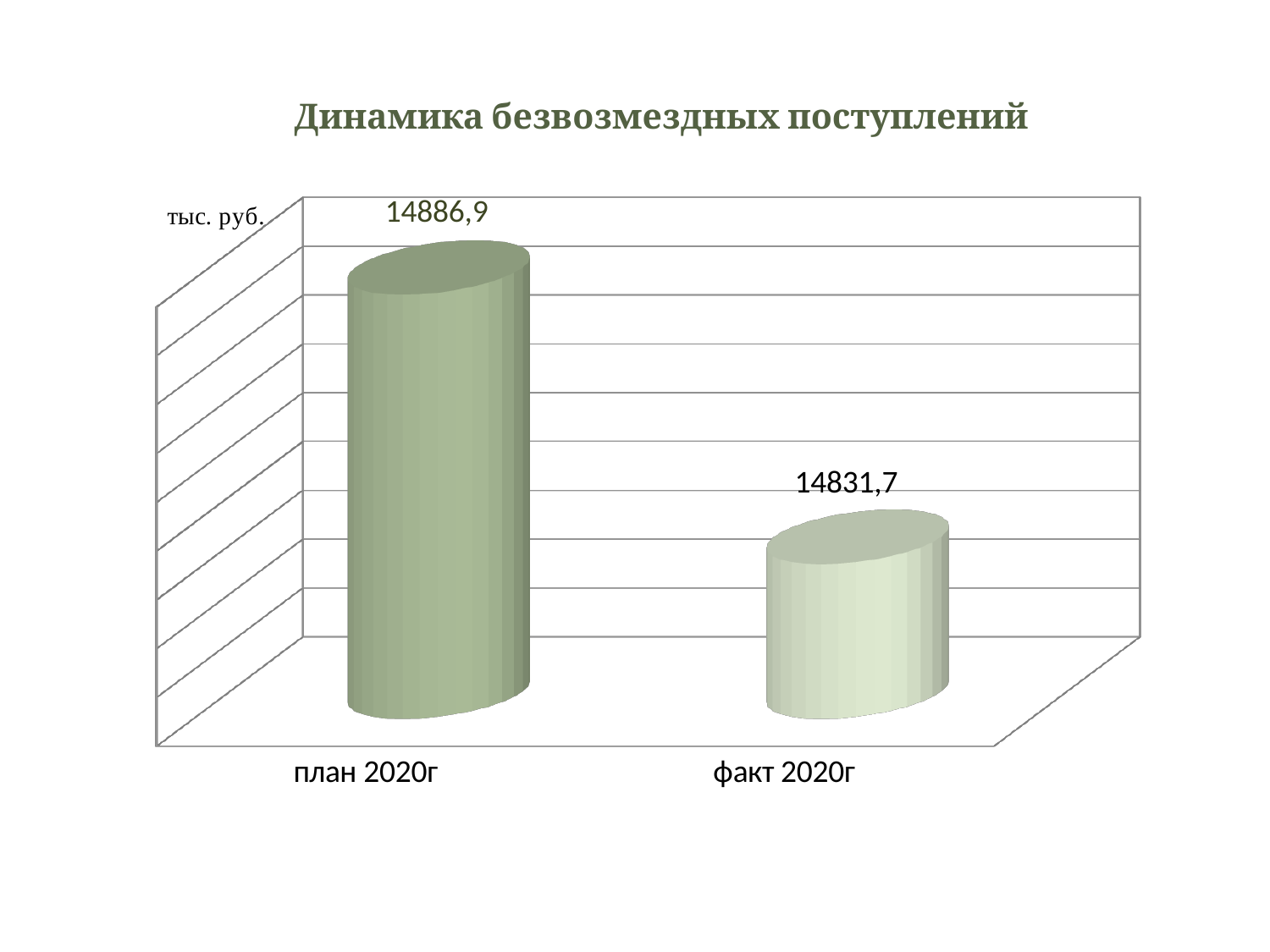
Which category has the highest value? план 2020г What is the value for план 2020г? 14886,9 What is the title of the chart? Динамика безвозмездных поступлений Which is larger, the value for план 2020г or the value for факт 2020г? план 2020г What kind of chart is shown on the slide? bar chart What is the difference between the values for план 2020г and факт 2020г? 55,2 What is the value for факт 2020г? 14831,7 How many categories are shown on the chart? 2 Do the values rise or fall from план 2020г to факт 2020г? fall What unit is indicated on the chart? тыс. руб. Which category has the lowest value? факт 2020г